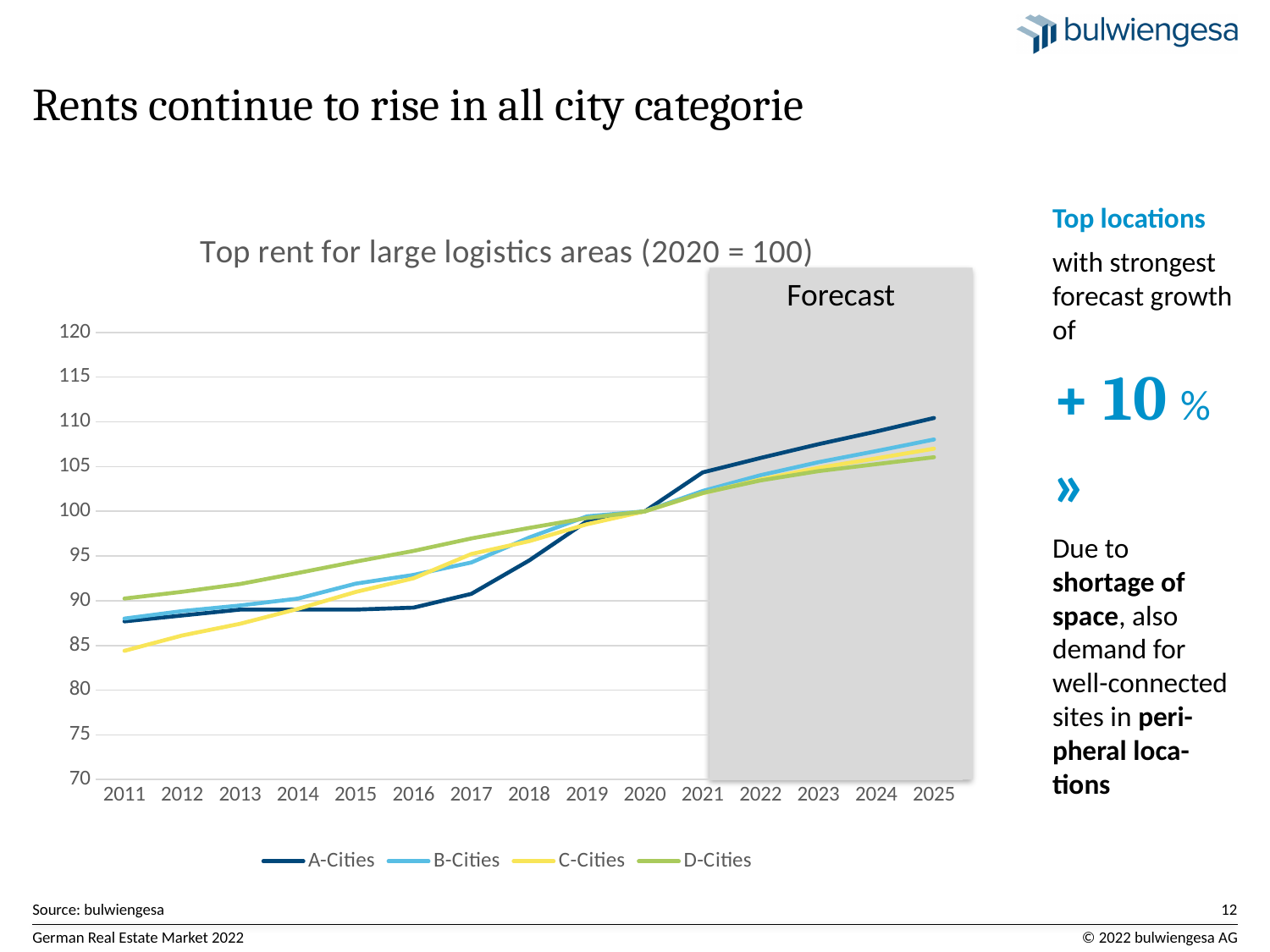
How many years are shown on the x axis of the chart? 15 Is the value for A-Cities in 2025 greater or less than 105? greater What is the index value for A-Cities in 2020? 100 How many series does the chart legend list? 4 Do the values for B-Cities rise or fall from 2011 to 2025? rise Which series has the highest value in 2025? A-Cities What kind of chart is shown on the slide? line chart Which series has the highest value in 2011? D-Cities In 2017, which is larger: the value for D-Cities or the value for A-Cities? D-Cities Which series has the lowest value in 2011? C-Cities What is the title of the chart? Top rent for large logistics areas (2020 = 100) Is the value for C-Cities in 2011 greater or less than 90? less